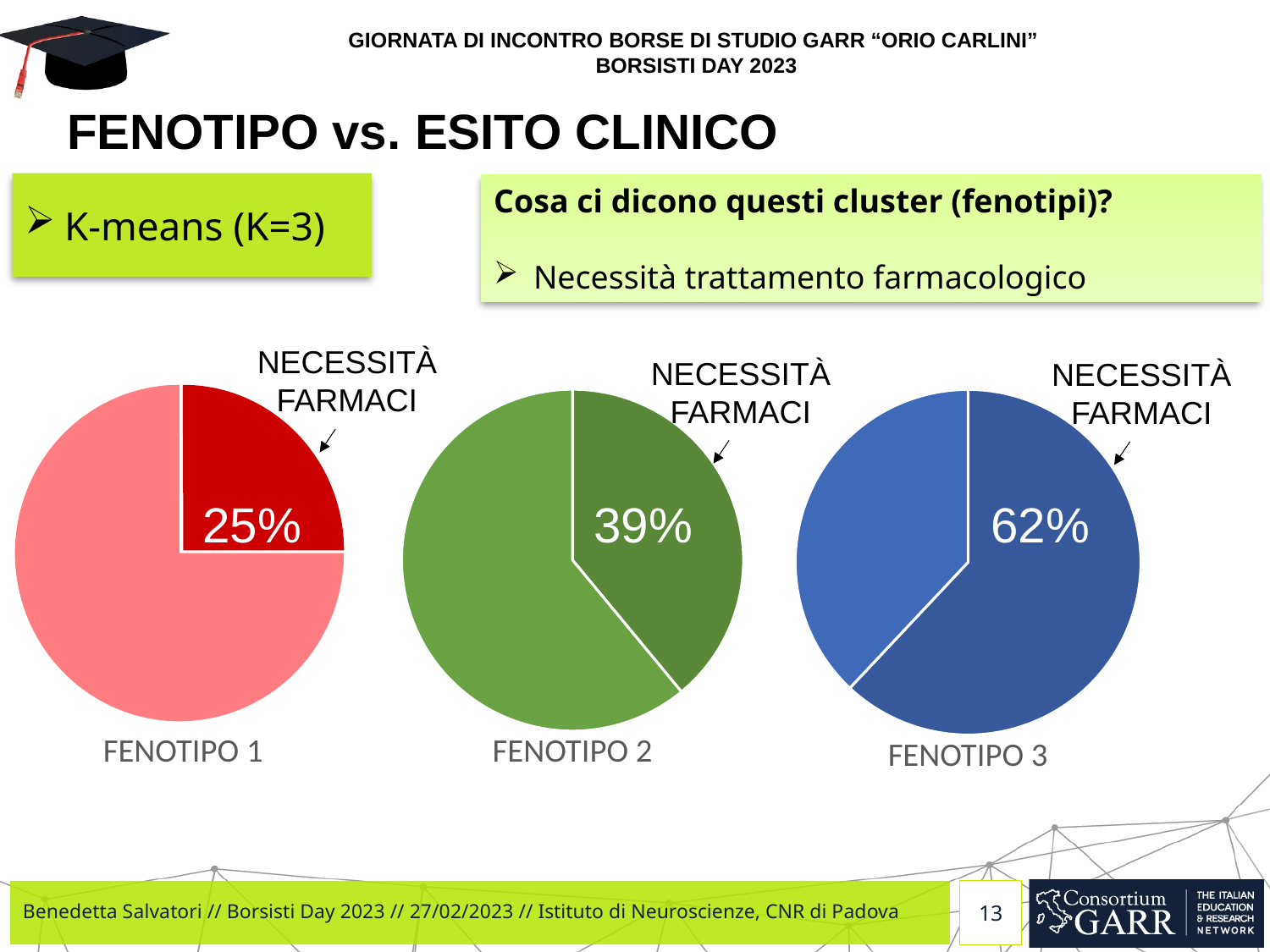
In the FENOTIPO 3 chart, what percentage is labelled for the NECESSITÀ FARMACI slice? 62% In the FENOTIPO 1 chart, what percentage is labelled for the NECESSITÀ FARMACI slice? 25% In the FENOTIPO 2 chart, what percentage is labelled for the NECESSITÀ FARMACI slice? 39% How many pie charts are shown on the slide? 3 Across the three charts, which fenotipo has the highest NECESSITÀ FARMACI percentage? FENOTIPO 3 How many slices does the FENOTIPO 2 pie chart have? 2 What is the difference in percentage points between the NECESSITÀ FARMACI value in the FENOTIPO 3 chart and the one in the FENOTIPO 1 chart? 37 What kind of chart is used for FENOTIPO 1, FENOTIPO 2 and FENOTIPO 3? Pie chart Across the three charts, which fenotipo has the lowest NECESSITÀ FARMACI percentage? FENOTIPO 1 Is the NECESSITÀ FARMACI percentage larger in the FENOTIPO 2 chart or in the FENOTIPO 3 chart? FENOTIPO 3 What colour is the FENOTIPO 3 pie chart? Blue What is the difference in percentage points between the NECESSITÀ FARMACI value in the FENOTIPO 2 chart and the one in the FENOTIPO 1 chart? 14